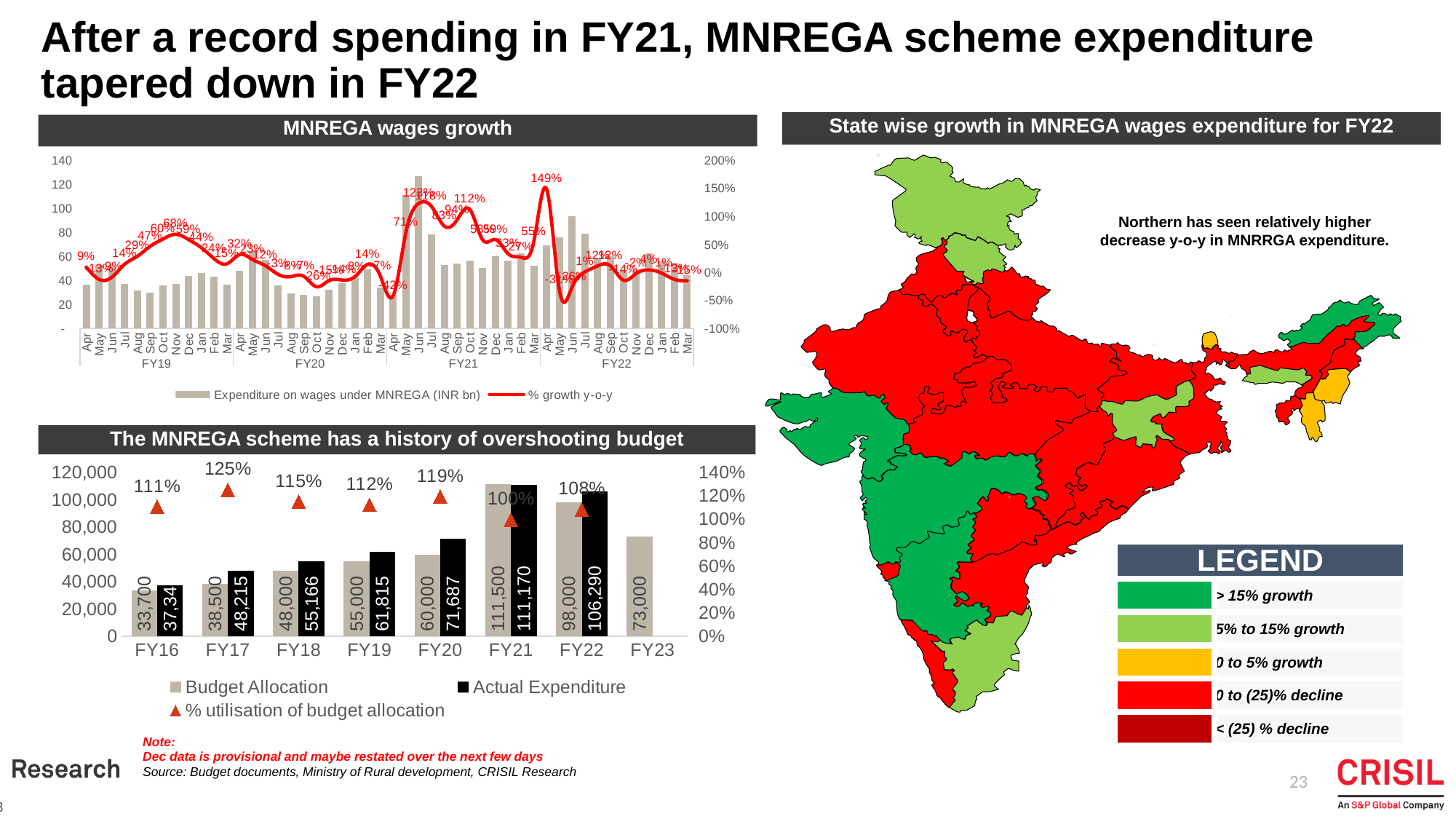
In the 'MNREGA wages growth' chart, how many series does the legend list? 2 In the 'MNREGA wages growth' chart, what is the highest % growth y-o-y value labelled on the line? 149% In the chart 'The MNREGA scheme has a history of overshooting budget', how many fiscal years are shown on the x axis? 8 In the chart 'The MNREGA scheme has a history of overshooting budget', which fiscal year has the highest % utilisation of budget allocation? FY17 In the chart 'The MNREGA scheme has a history of overshooting budget', what is the Actual Expenditure for FY20? 71,687 In the chart 'The MNREGA scheme has a history of overshooting budget', by how much does Actual Expenditure exceed Budget Allocation in FY22? 8,290 In the chart 'The MNREGA scheme has a history of overshooting budget', how many series does the legend list? 3 In the chart 'The MNREGA scheme has a history of overshooting budget', what is the % utilisation of budget allocation for FY17? 125% In the chart 'The MNREGA scheme has a history of overshooting budget', which is larger for FY18: Budget Allocation or Actual Expenditure? Actual Expenditure In the chart 'The MNREGA scheme has a history of overshooting budget', which fiscal year has the lowest % utilisation of budget allocation? FY21 In the chart 'The MNREGA scheme has a history of overshooting budget', what is the Budget Allocation for FY23? 73,000 In the chart 'The MNREGA scheme has a history of overshooting budget', what is the Budget Allocation for FY21? 111,500